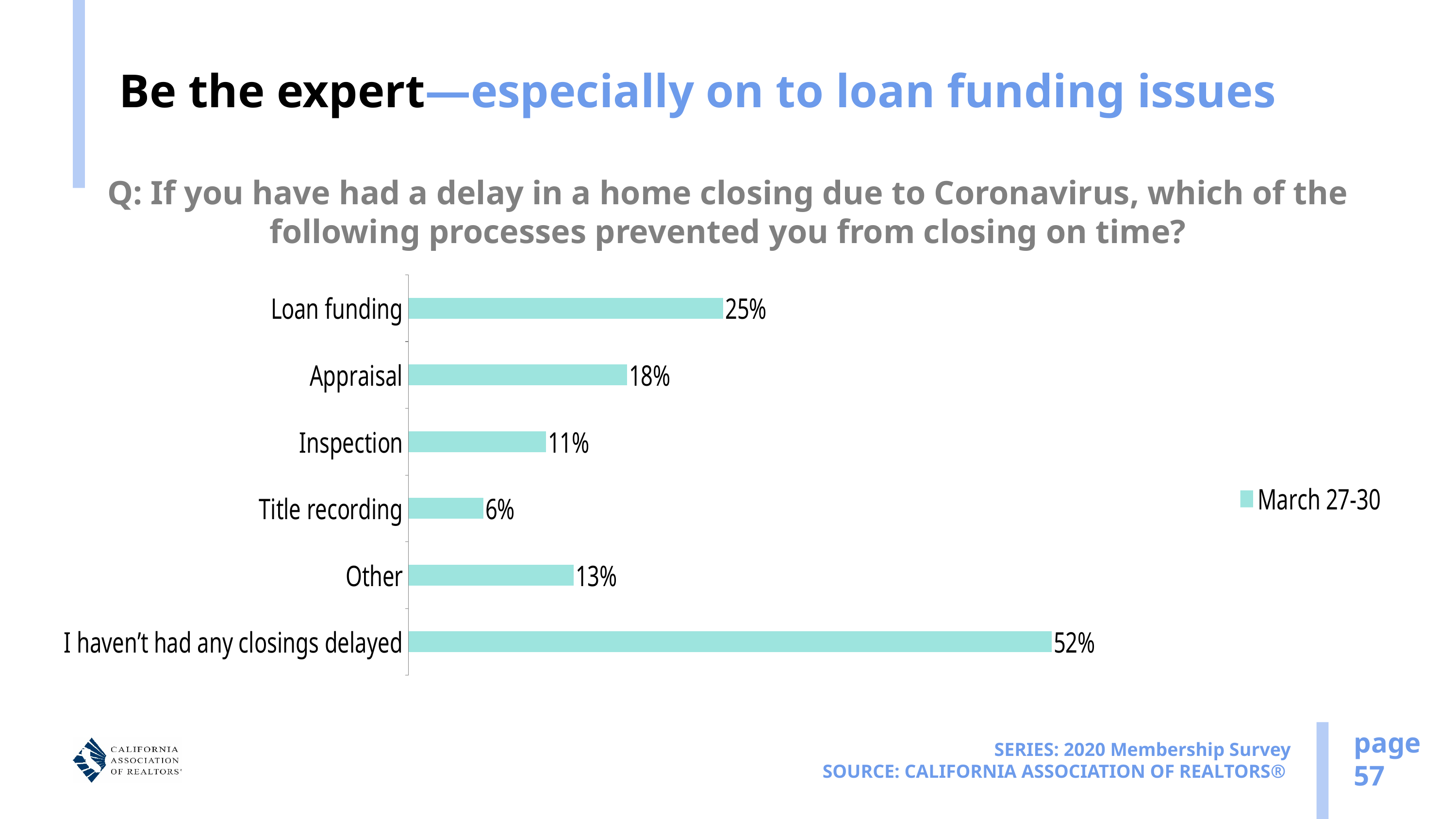
What is the value shown for Title recording? 6% Which category has the lowest value in the chart? Title recording What percentage of respondents said they haven't had any closings delayed? 52% How many series does the legend list? 1 Which category has the highest value in the chart? I haven't had any closings delayed What is the value shown for Appraisal? 18% What kind of chart is shown on the slide? Bar chart Which is larger, the value for Inspection or the value for Other? Other What is the legend entry for the series shown in the chart? March 27-30 How many categories are shown in the chart? 6 What percentage of respondents cited Loan funding as the process that prevented them from closing on time? 25% What is the difference in percentage points between Loan funding and Appraisal? 7 percentage points